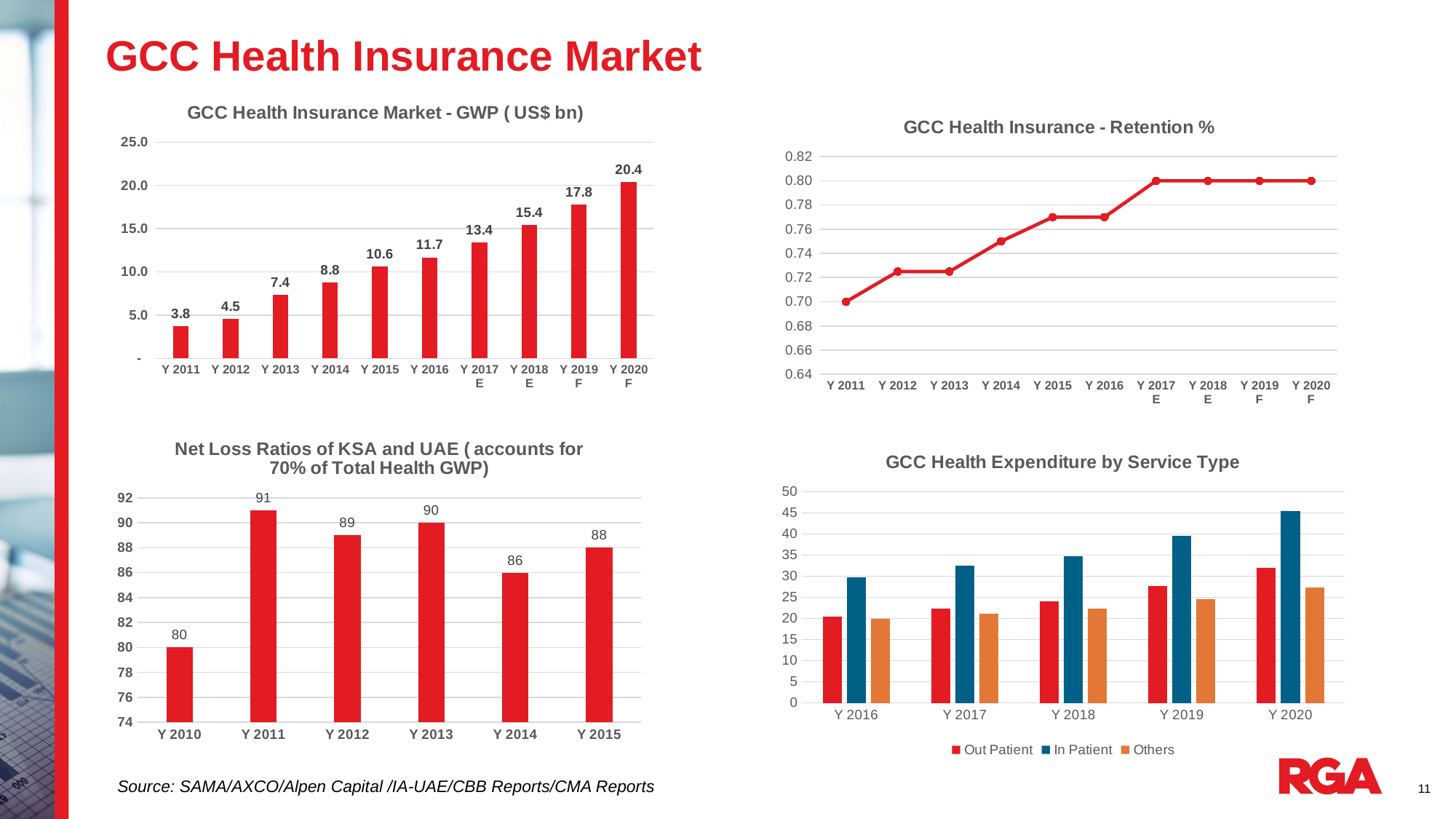
In the GCC Health Insurance Market - GWP chart, which year has the lowest value? Y 2011 In the GCC Health Insurance Market - GWP chart, do the values rise or fall from Y 2011 to Y 2020 F? rise In the GCC Health Expenditure by Service Type chart, how many series does the legend list? 3 In the GCC Health Insurance Market - GWP chart, what is the difference between Y 2019 F and Y 2018 E? 2.4 In the GCC Health Insurance - Retention % chart, what is the value for Y 2011? 0.70 In the GCC Health Insurance Market - GWP chart, what is the value for Y 2020 F? 20.4 In the GCC Health Expenditure by Service Type chart, is the In Patient value for Y 2020 greater or less than 40? greater In the GCC Health Insurance - Retention % chart, what is the value for Y 2018 E? 0.80 In the Net Loss Ratios of KSA and UAE chart, what is the difference between Y 2013 and Y 2014? 4 What kind of chart is the GCC Health Insurance - Retention % chart? line chart In the Net Loss Ratios of KSA and UAE chart, which year has the highest value? Y 2011 In the GCC Health Insurance - Retention % chart, how many years are plotted? 10